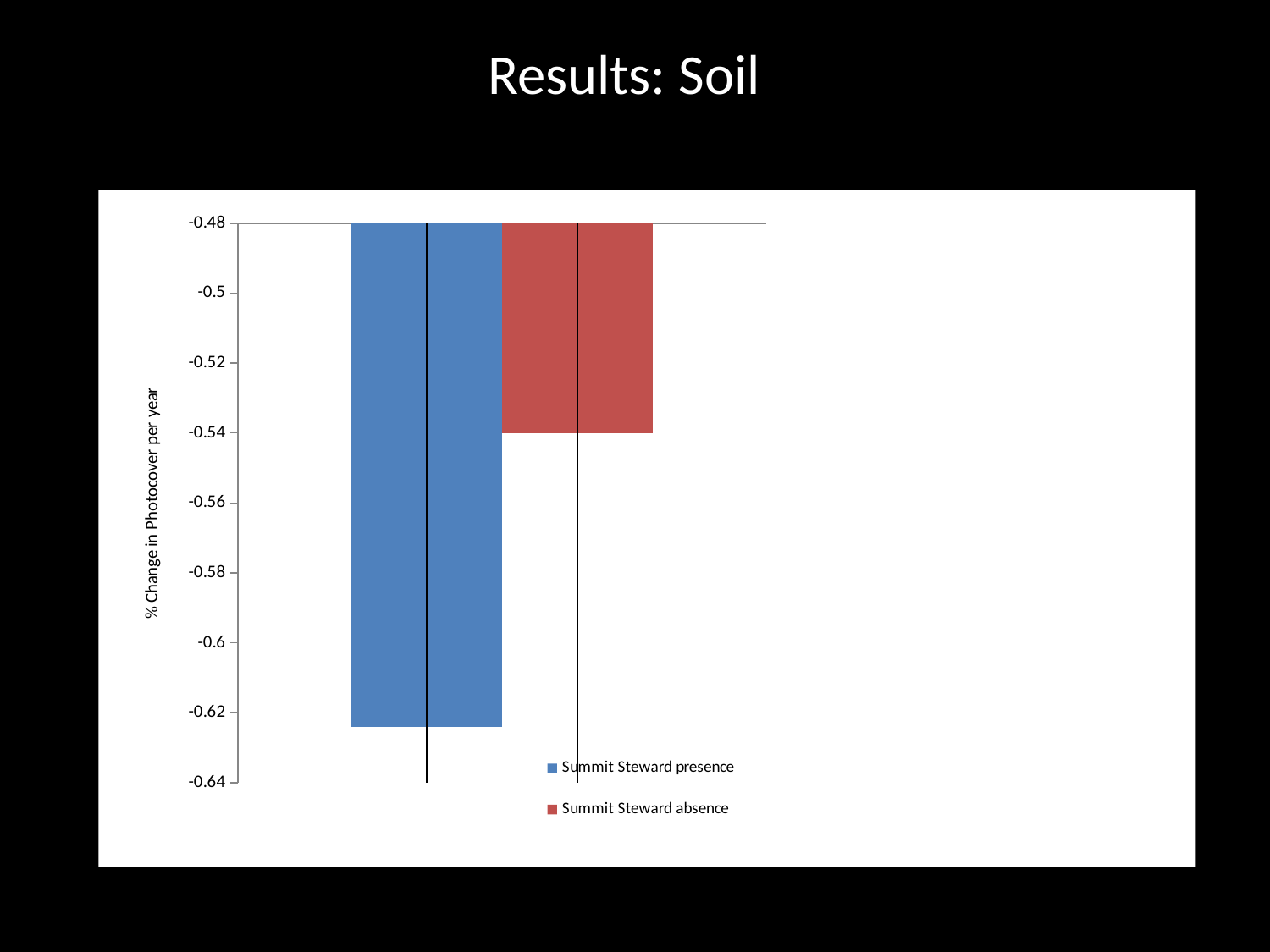
Which series has the value closest to zero (least negative)? Summit Steward absence Is the value for Summit Steward absence greater or less than -0.52? less Is the value for Summit Steward absence greater or less than -0.56? greater How many bars are plotted in the chart? 2 Which series has the more negative value, Summit Steward presence or Summit Steward absence? Summit Steward presence Is the value for Summit Steward presence greater or less than -0.6? less Which series has the lowest (most negative) value? Summit Steward presence Which colour represents Summit Steward absence in the legend? red What is the label on the vertical axis of the chart? % Change in Photocover per year How many series does the legend list? 2 What kind of chart is shown on the slide? bar chart